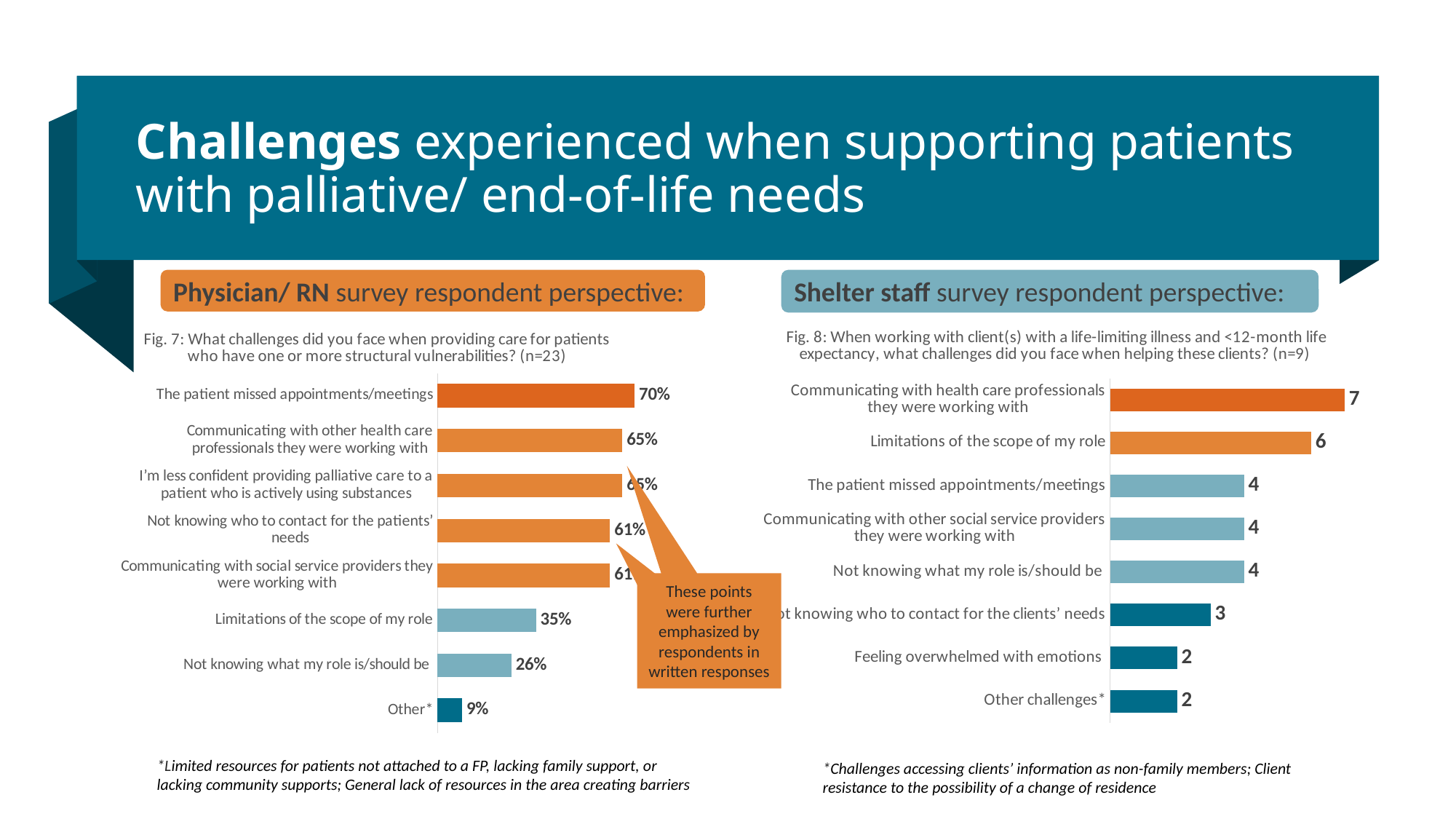
In Fig. 8 (Shelter staff perspective), how many respondents reported 'Communicating with health care professionals they were working with' as a challenge? 7 In Fig. 7 (Physician/RN perspective), which challenge has the highest percentage? The patient missed appointments/meetings In Fig. 7 (Physician/RN perspective), how many challenge categories are plotted? 8 In Fig. 8 (Shelter staff perspective), which is larger: 'Limitations of the scope of my role' or 'The patient missed appointments/meetings'? Limitations of the scope of my role What type of chart is used in Fig. 8 (Shelter staff perspective)? Bar chart In Fig. 7 (Physician/RN perspective), what percentage is shown for 'Limitations of the scope of my role'? 35% In Fig. 8 (Shelter staff perspective), which challenge has the highest value? Communicating with health care professionals they were working with In Fig. 8 (Shelter staff perspective), what is the difference between 'Limitations of the scope of my role' and 'Not knowing who to contact for the clients' needs'? 3 In Fig. 8 (Shelter staff perspective), what value is shown for 'Feeling overwhelmed with emotions'? 2 In Fig. 7 (Physician/RN perspective), which challenge has the lowest percentage? Other* In Fig. 7 (Physician/RN perspective), what percentage of respondents reported that the patient missed appointments/meetings? 70% In Fig. 7 (Physician/RN perspective), what is the difference between 'The patient missed appointments/meetings' and 'Not knowing what my role is/should be'? 44%